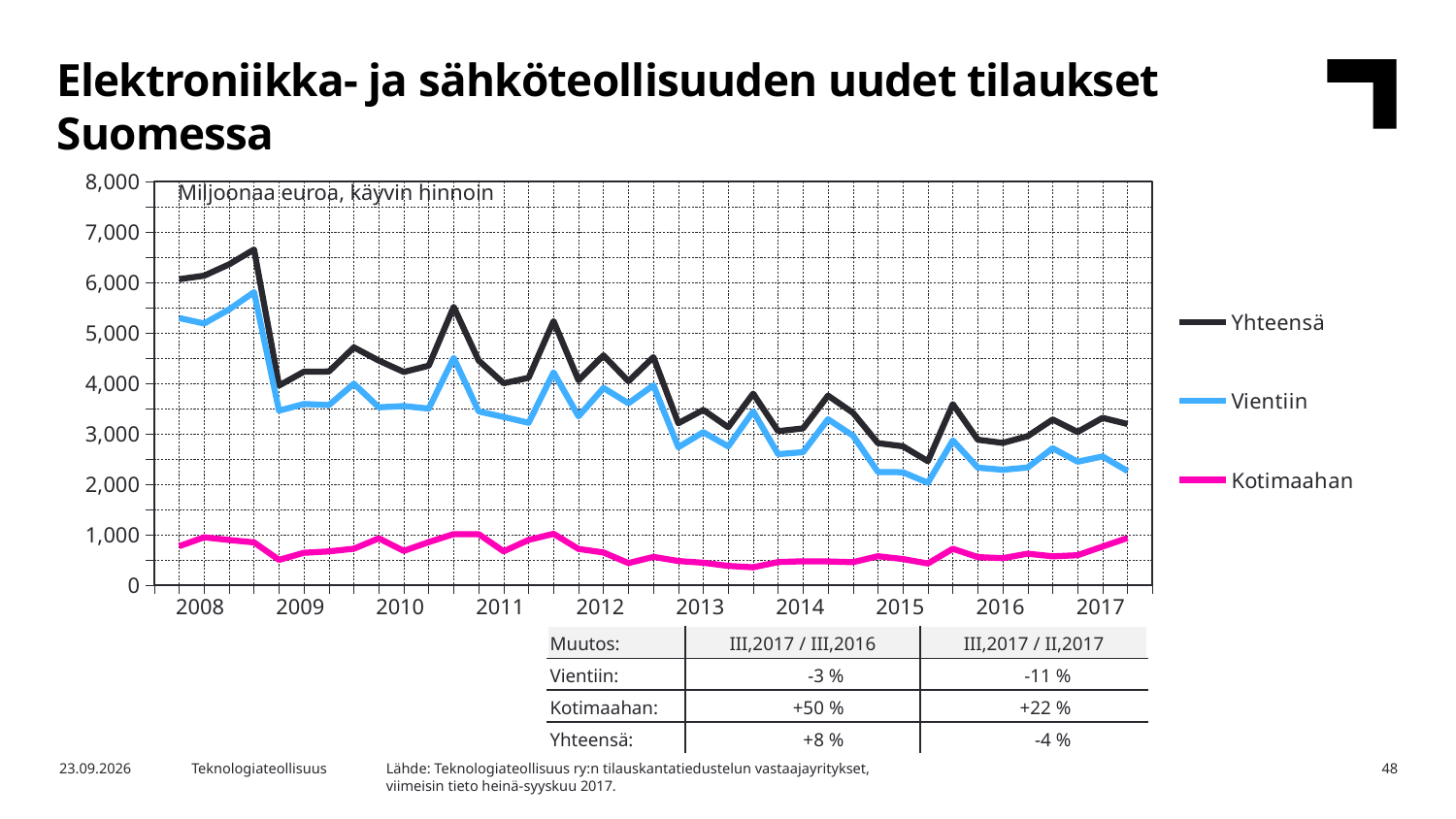
In which year does the Yhteensä series reach its highest value? 2008 What unit label is shown inside the chart area? Miljoonaa euroa, käyvin hinnoin Which series has the lowest values throughout the chart? Kotimaahan How many series does the legend list? 3 Which series are listed in the legend? Yhteensä, Vientiin, Kotimaahan Which series is larger, Vientiin or Kotimaahan? Vientiin Is the value for Kotimaahan ever greater or less than 2,000 across the chart? less Is the peak value of Yhteensä in 2008 greater or less than 6,000? greater What type of chart is shown on the slide? line chart Does the Yhteensä series generally rise or fall from 2008 to 2017? fall How many years are labelled on the x axis? 10 Is the last value for Vientiin in 2017 greater or less than 3,000? less